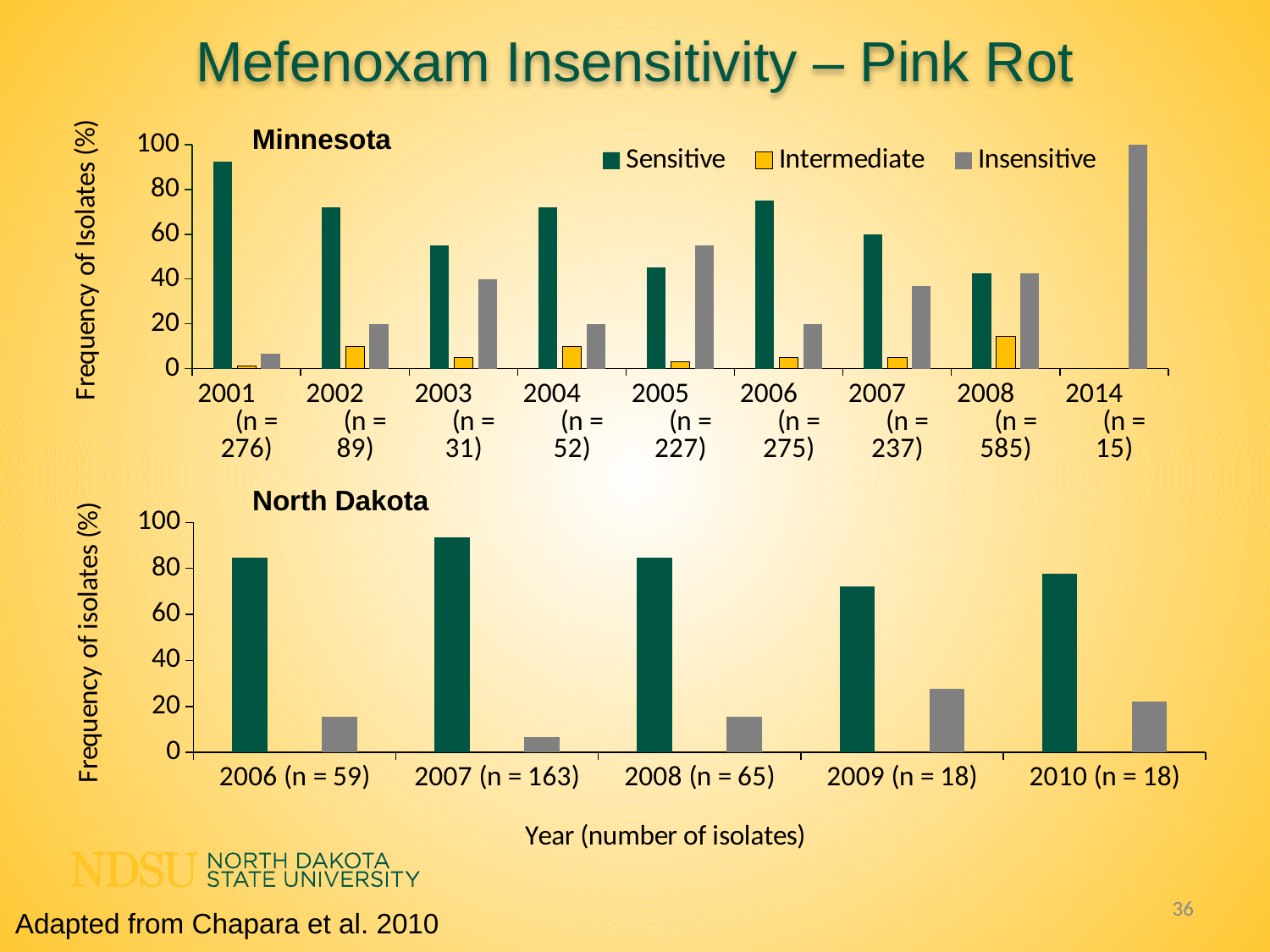
On the Minnesota chart, which is larger in 2003, the Sensitive value or the Insensitive value? Sensitive On the North Dakota chart, which year has the highest Sensitive value? 2007 On the Minnesota chart, is the Insensitive value for 2005 greater or less than 40? greater On the North Dakota chart, which year has the lowest Insensitive value? 2007 How many series does the legend on the Minnesota chart list? 3 On the Minnesota chart, is the Intermediate value for 2008 greater or less than 20? less How many years are shown on the Minnesota chart? 9 On the North Dakota chart, is the Insensitive value for 2009 greater or less than 20? greater What type of chart is the North Dakota chart? bar chart On the Minnesota chart, which year has the highest Sensitive value? 2001 On the Minnesota chart, which year has the highest Insensitive value? 2014